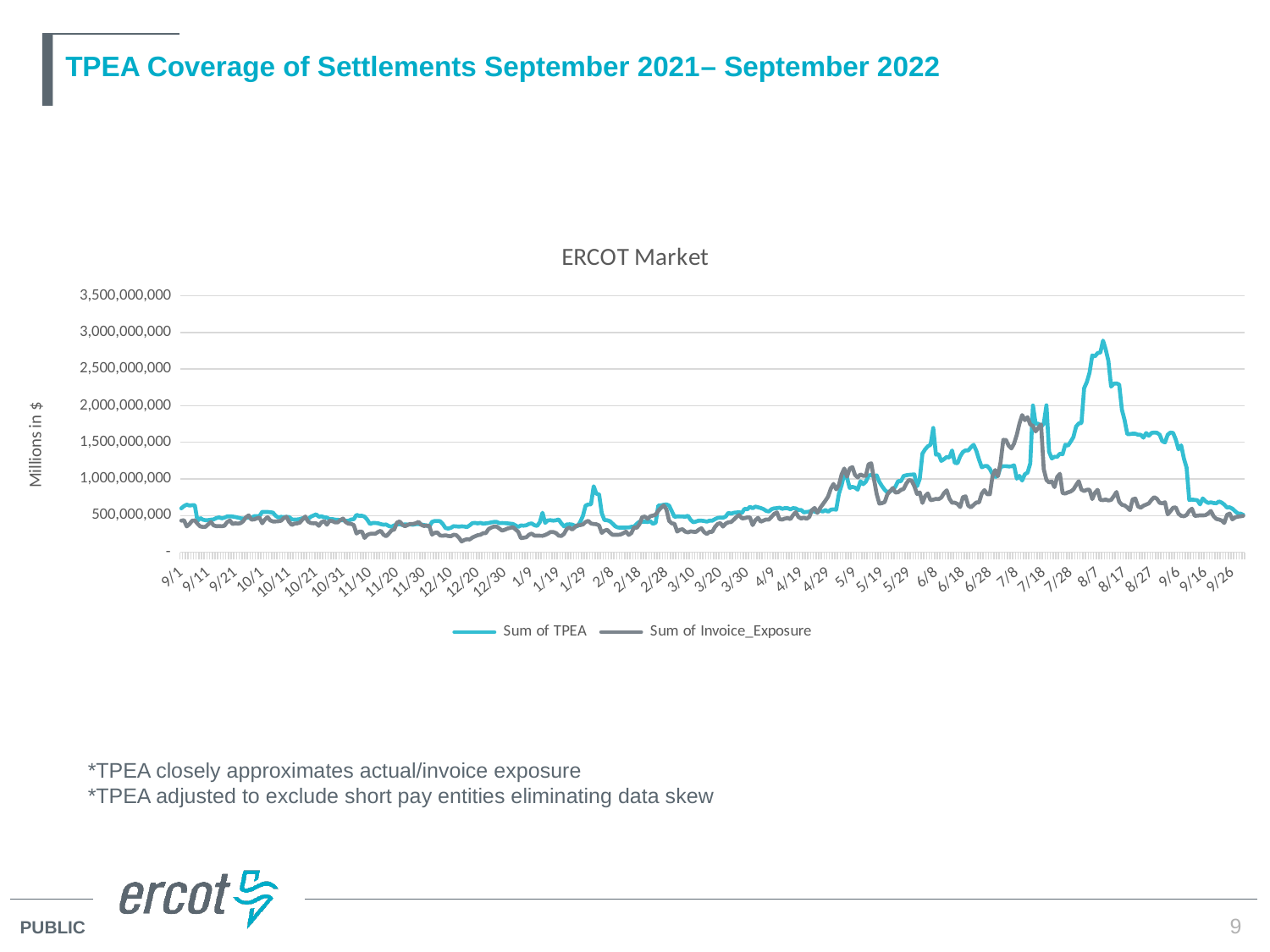
Is the value of Sum of TPEA at 9/1 greater or less than 1,000,000,000? less Is the peak value of Sum of TPEA around 8/7 greater or less than 2,500,000,000? greater What kind of chart is shown on the slide? Line chart Which series reaches the highest value on the chart? Sum of TPEA Is the value of Sum of TPEA around 6/8 greater or less than 1,000,000,000? greater What is the title of the chart? ERCOT Market How many series does the chart legend list? 2 What is the label on the vertical axis of the chart? Millions in $ What is the highest value shown on the vertical axis? 3,500,000,000 Around 8/7, which series has the larger value, Sum of TPEA or Sum of Invoice_Exposure? Sum of TPEA